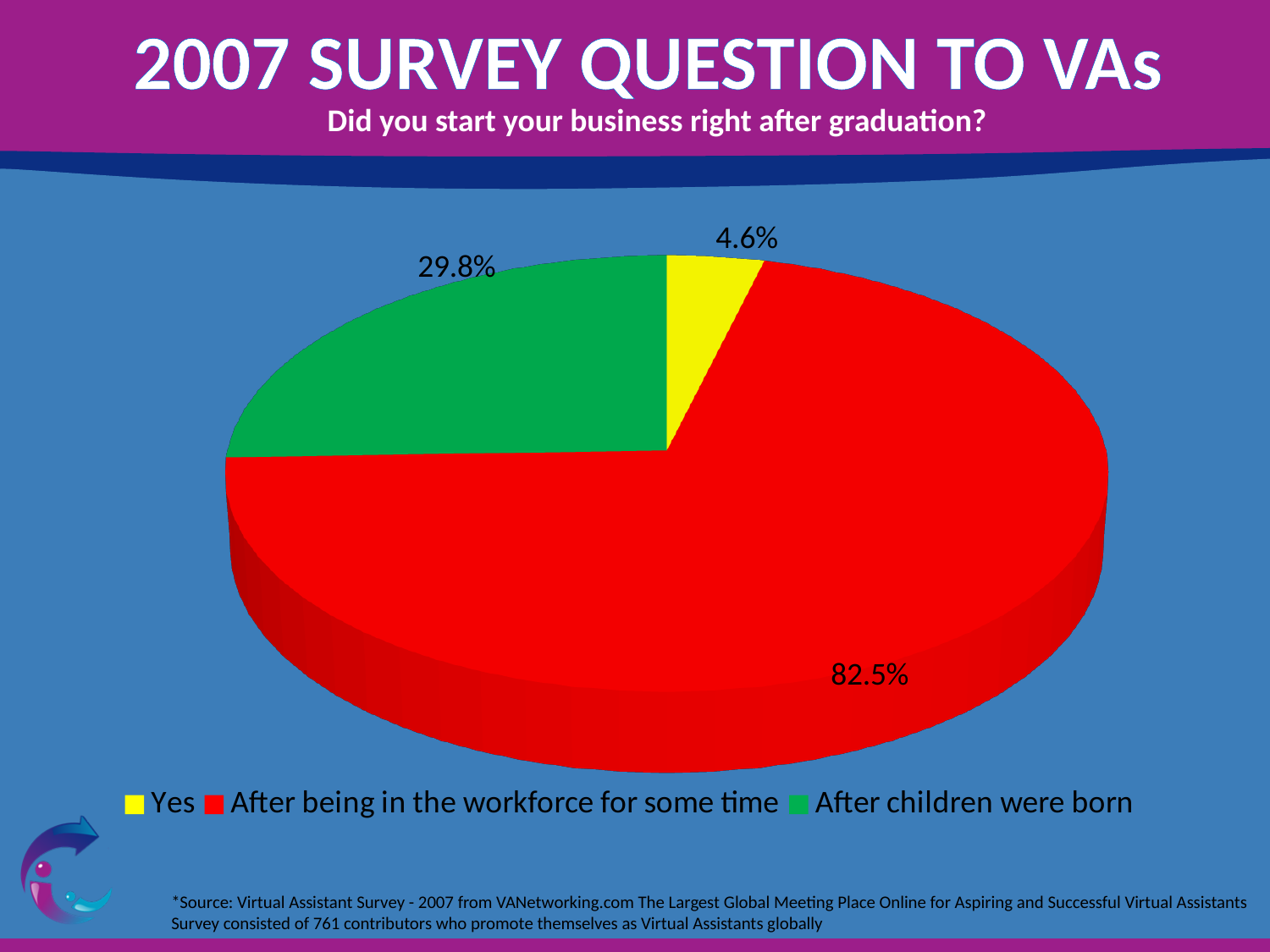
What survey question is shown as the subtitle above the chart? Did you start your business right after graduation? Which response has the smallest slice of the pie? Yes Which response has the largest slice of the pie? After being in the workforce for some time What kind of chart is shown on the slide? pie chart What percentage is shown for "After children were born"? 29.8% How many slices does the pie chart have? 3 What percentage is shown for "After being in the workforce for some time"? 82.5% What percentage is shown for the "Yes" slice? 4.6% How many entries does the legend list? 3 What is the difference in percentage points between "After being in the workforce for some time" and "After children were born"? 52.7 What colour is the slice for "After children were born"? green Which is larger: the slice for "After children were born" or the slice for "Yes"? After children were born